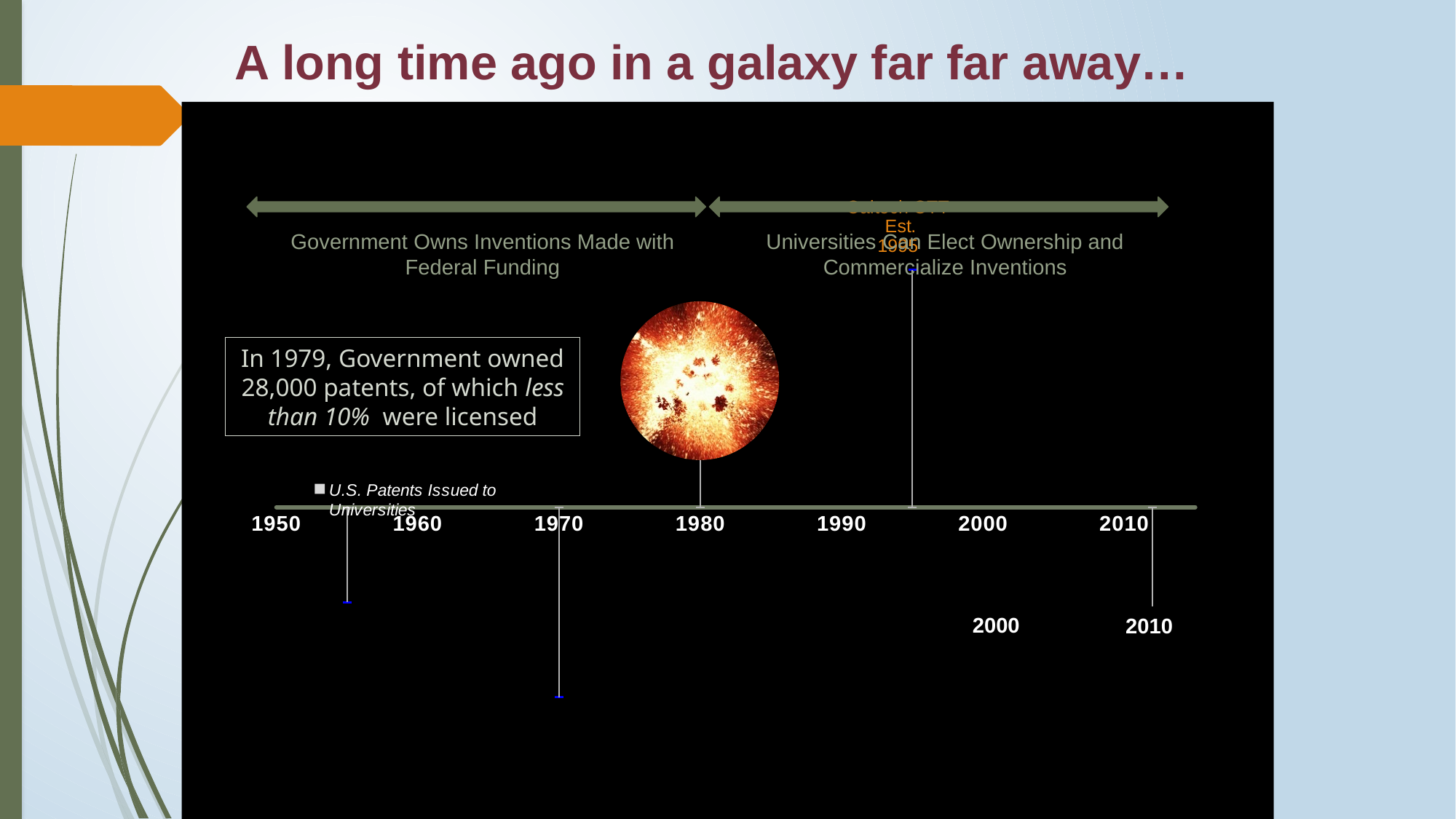
How many year labels are shown along the chart's x axis? 7 What is the last year label on the chart's x axis? 2010 What series does the chart legend list? U.S. Patents Issued to Universities How many series does the chart legend list? 1 What is the first year label on the chart's x axis? 1950